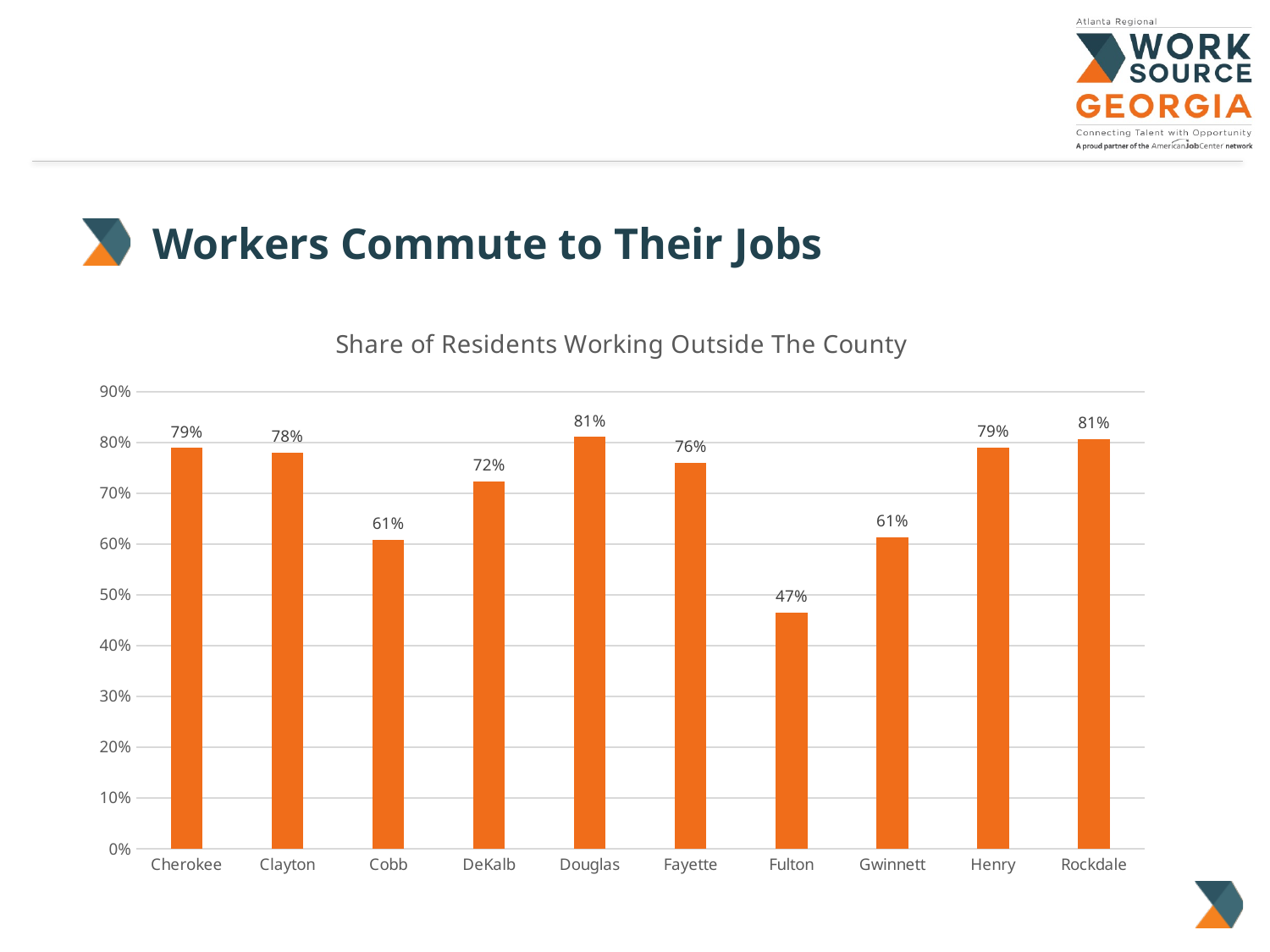
What is the title of the chart? Share of Residents Working Outside The County What is the difference between the values for Cherokee and Cobb? 18% What kind of chart is shown on the slide? Bar chart What is the share of residents working outside the county for Fulton? 47% Which county has the lowest share of residents working outside the county? Fulton What is the value shown for DeKalb? 72% What is the value shown for Fayette? 76% What is the difference between the values for Douglas and Fulton? 34% Is the value for Fulton greater or less than 50%? less What is the value shown for Clayton? 78% How many counties are shown on the chart? 10 Which is larger, the value for Henry or the value for Gwinnett? Henry